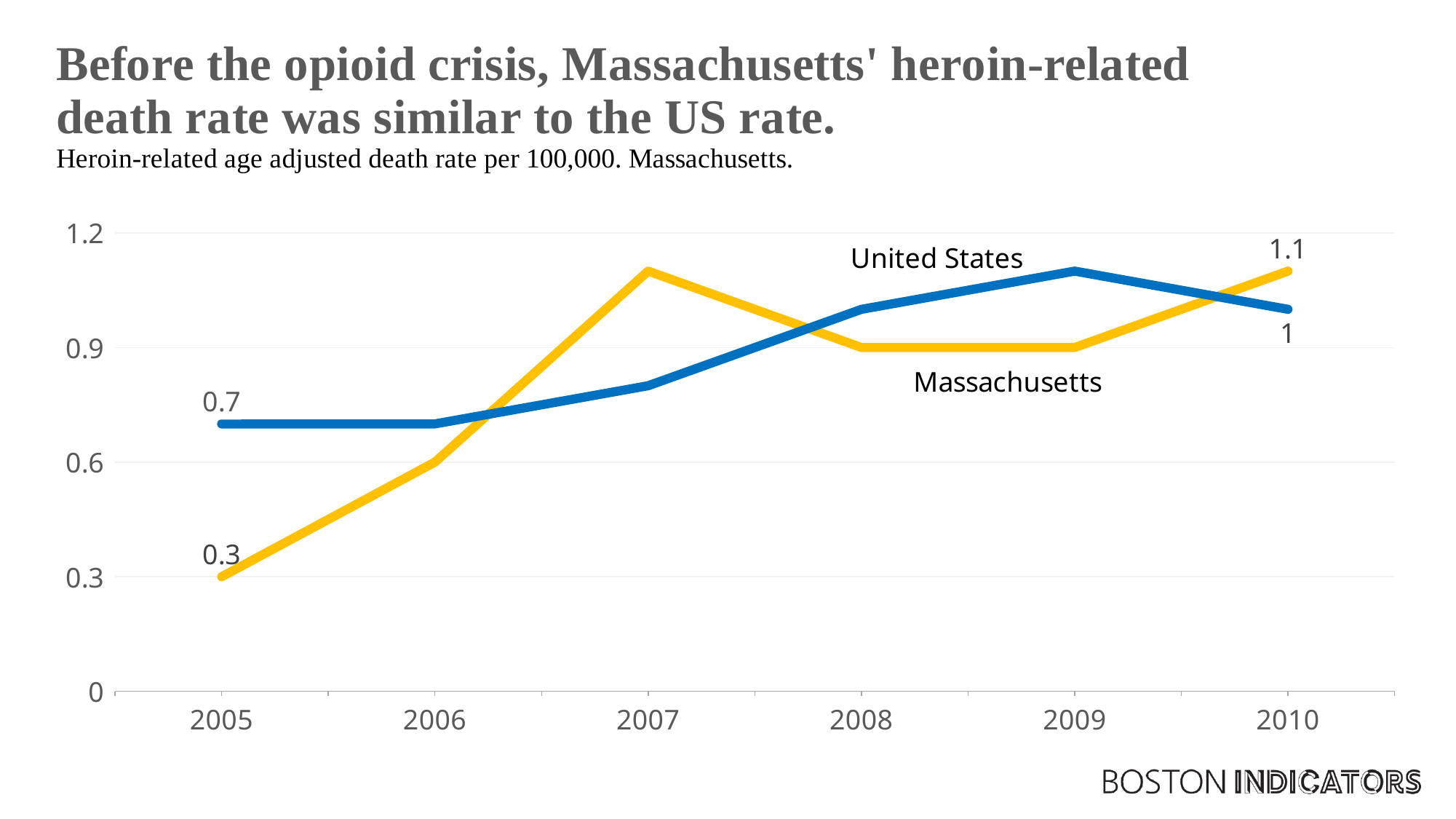
What was the United States heroin-related death rate in 2010? 1 What kind of chart is shown on the slide? Line chart In 2010, which had the higher heroin-related death rate, the United States or Massachusetts? Massachusetts Is the United States value for 2007 greater or less than 0.9? less In 2005, which had the higher heroin-related death rate, the United States or Massachusetts? United States Is the Massachusetts value for 2007 greater or less than 0.9? greater How many years are shown on the x axis? 6 What was the Massachusetts heroin-related death rate in 2005? 0.3 How many series are plotted on the chart? 2 What was the Massachusetts heroin-related death rate in 2010? 1.1 What is the difference between the United States and Massachusetts death rates in 2005? 0.4 What was the United States heroin-related death rate in 2005? 0.7